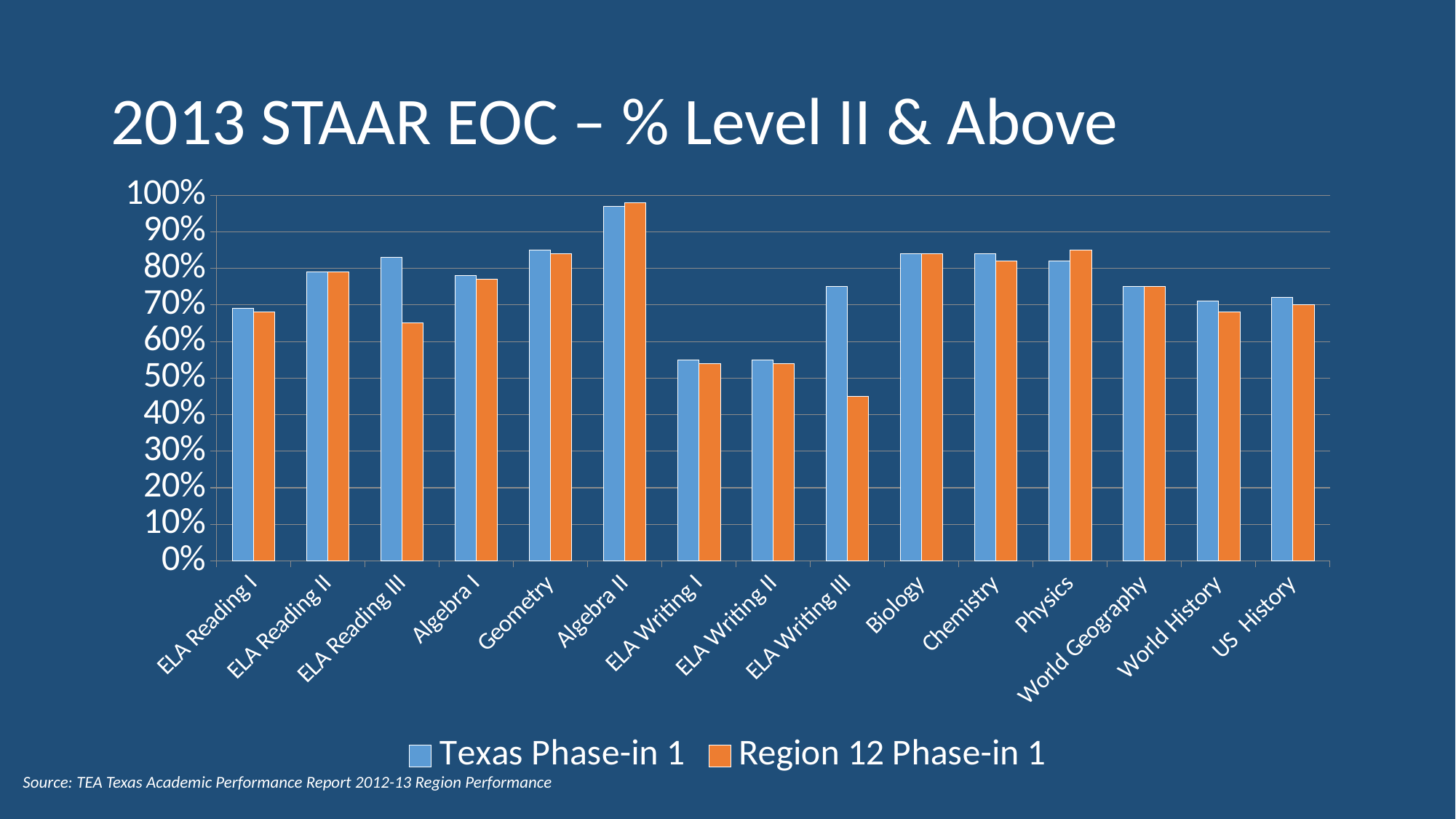
What kind of chart is shown on the slide? Bar chart Which subject has the lowest value for Region 12 Phase-in 1? ELA Writing III For Texas Phase-in 1, which is larger, Biology or ELA Writing I? Biology Is the Texas Phase-in 1 value for Geometry greater or less than 80%? greater Which subject has the highest value for Region 12 Phase-in 1? Algebra II How many subject categories are shown on the x axis? 15 Is the Region 12 Phase-in 1 value for ELA Reading III greater or less than 70%? less Is the Texas Phase-in 1 value for Algebra II greater or less than 90%? greater What is the title of the chart? 2013 STAAR EOC – % Level II & Above For ELA Writing III, which series has the larger value, Texas Phase-in 1 or Region 12 Phase-in 1? Texas Phase-in 1 How many series does the legend list? 2